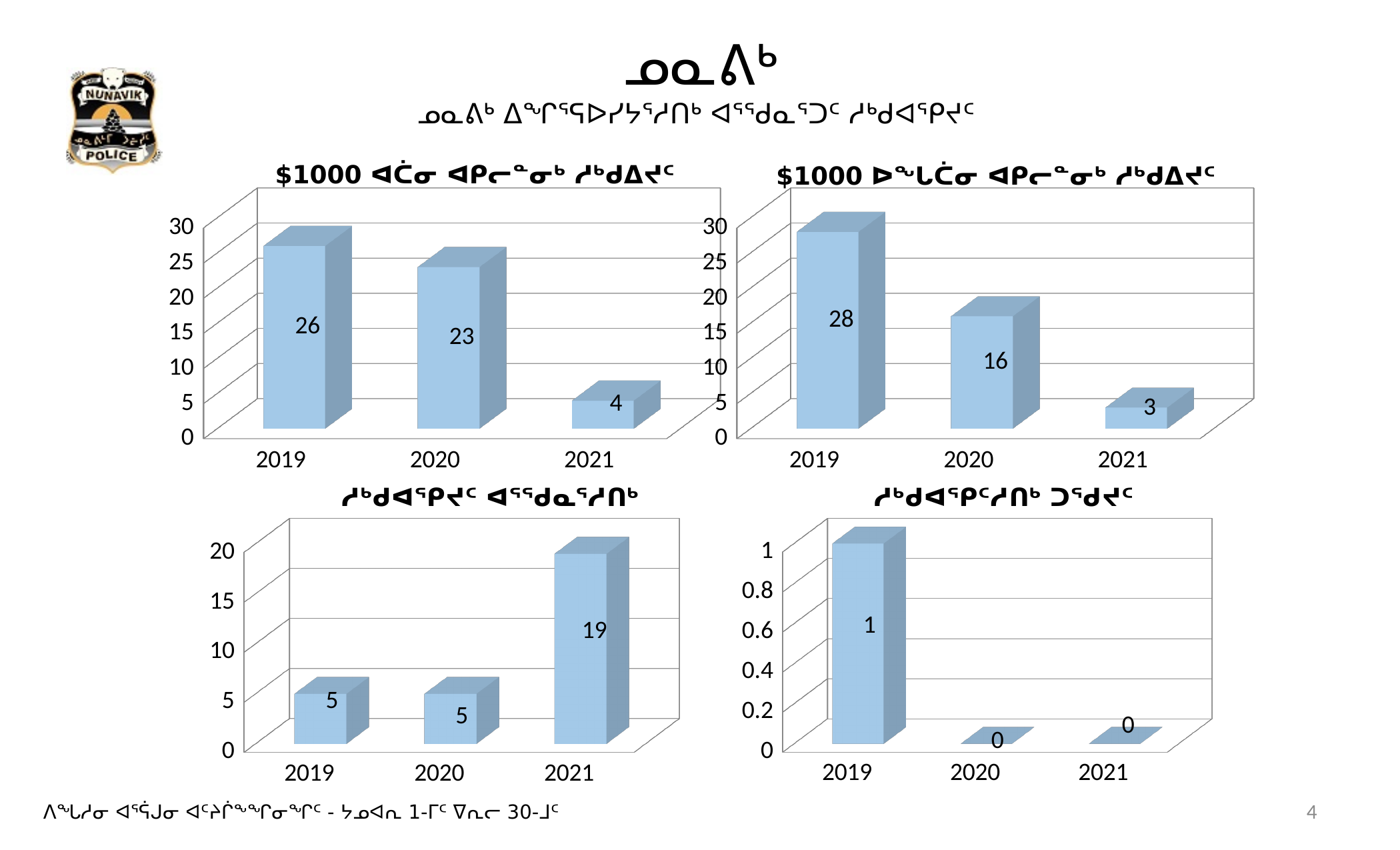
In the bottom-right chart, what is the value for 2019? 1 In the top-right chart, do the values rise or fall from 2019 to 2021? fall In the top-right chart, which year has the highest value? 2019 In the bottom-left chart, what is the value for 2021? 19 In the top-left chart, what is the value for 2019? 26 In the bottom-right chart, how many years are shown on the x axis? 3 In the top-right chart, what is the value for 2020? 16 What kind of chart is the bottom-left chart? bar chart In the top-left chart, which year has the lowest value? 2021 In the top-left chart, what is the difference between the values for 2019 and 2020? 3 Which is larger: the 2021 value in the top-left chart or the 2021 value in the top-right chart? top-left chart (4) In the bottom-left chart, what is the difference between the values for 2021 and 2020? 14